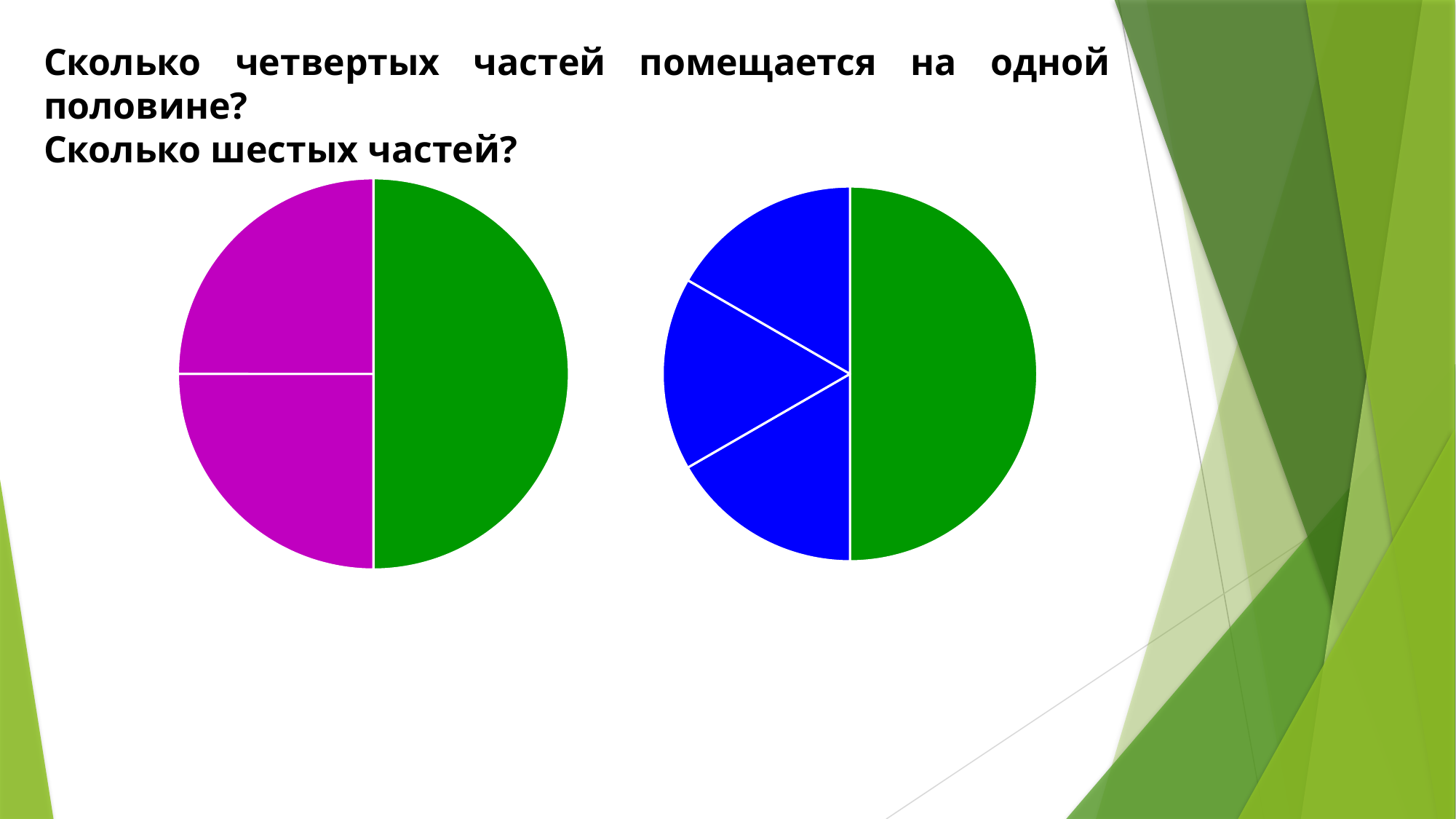
What kind of chart is the right chart on the slide? pie chart In the right chart, how many slices is the circle divided into? 4 In the left chart, what colour is the left half of the circle? purple What kind of chart is the left chart on the slide? pie chart In the left chart, how many purple slices are there? 2 In the left chart, which is larger: the green slice or one purple slice? the green slice In the left chart, which colour is the largest slice? green In the right chart, how many blue slices are there? 3 In the right chart, what colour is the left half of the circle? blue In the right chart, which is larger: the green slice or one blue slice? the green slice In the right chart, which colour is the largest slice? green